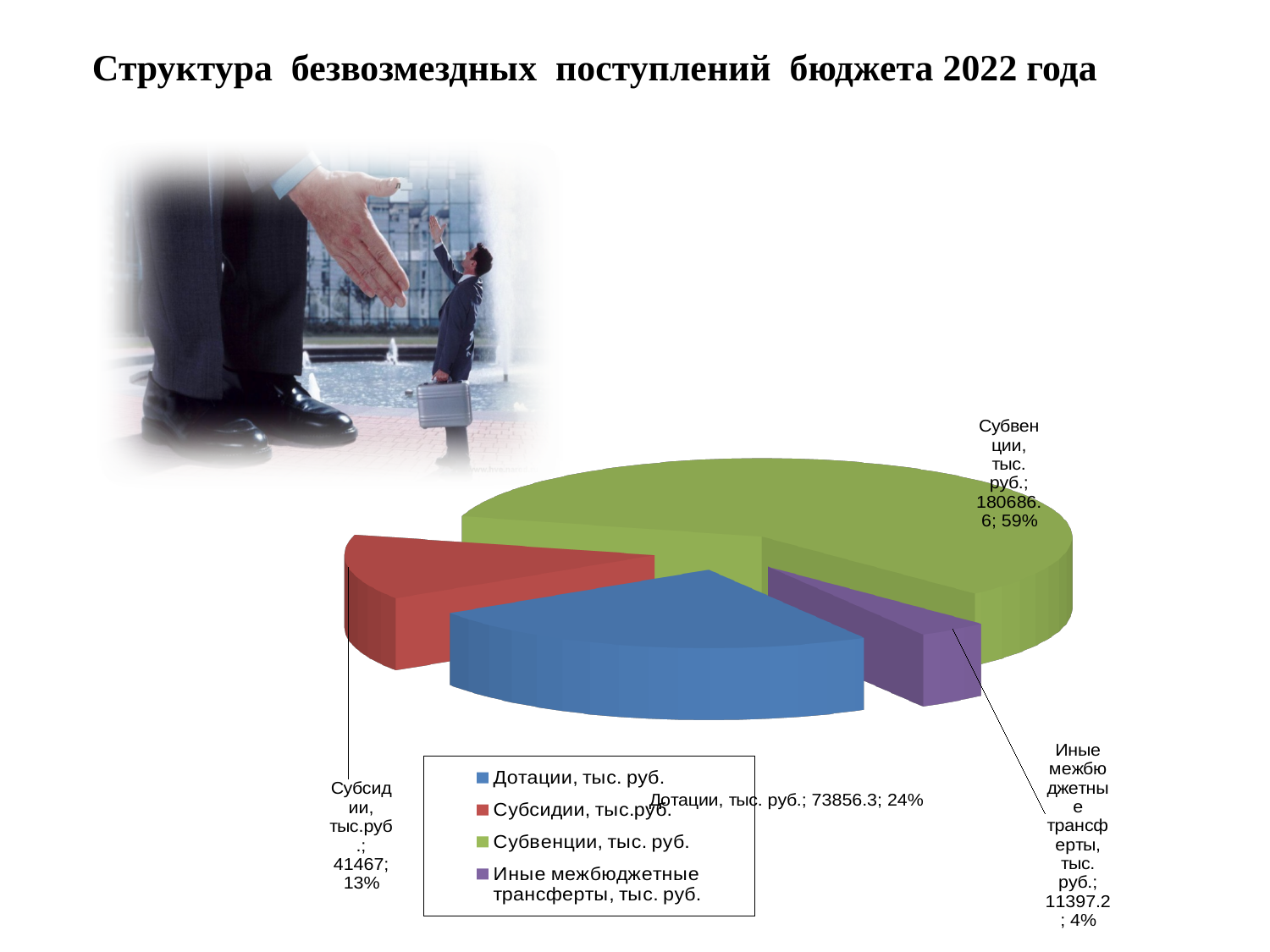
What share of the pie does Субсидии, тыс.руб. represent? 13% What is the value for Дотации, тыс. руб.? 73856.3 What is the title of the slide? Структура безвозмездных поступлений бюджета 2022 года What type of chart is shown on the slide? Pie chart What share of the pie does Субвенции, тыс. руб. represent? 59% Which category has the smallest slice of the pie? Иные межбюджетные трансферты, тыс. руб. What is the value for Иные межбюджетные трансферты, тыс. руб.? 11397.2 What is the value for Субсидии, тыс.руб.? 41467 Which category has the largest slice of the pie? Субвенции, тыс. руб. What is the value for Субвенции, тыс. руб.? 180686.6 Which is larger: Дотации, тыс. руб. or Субсидии, тыс.руб.? Дотации, тыс. руб. How many categories does the legend list? 4